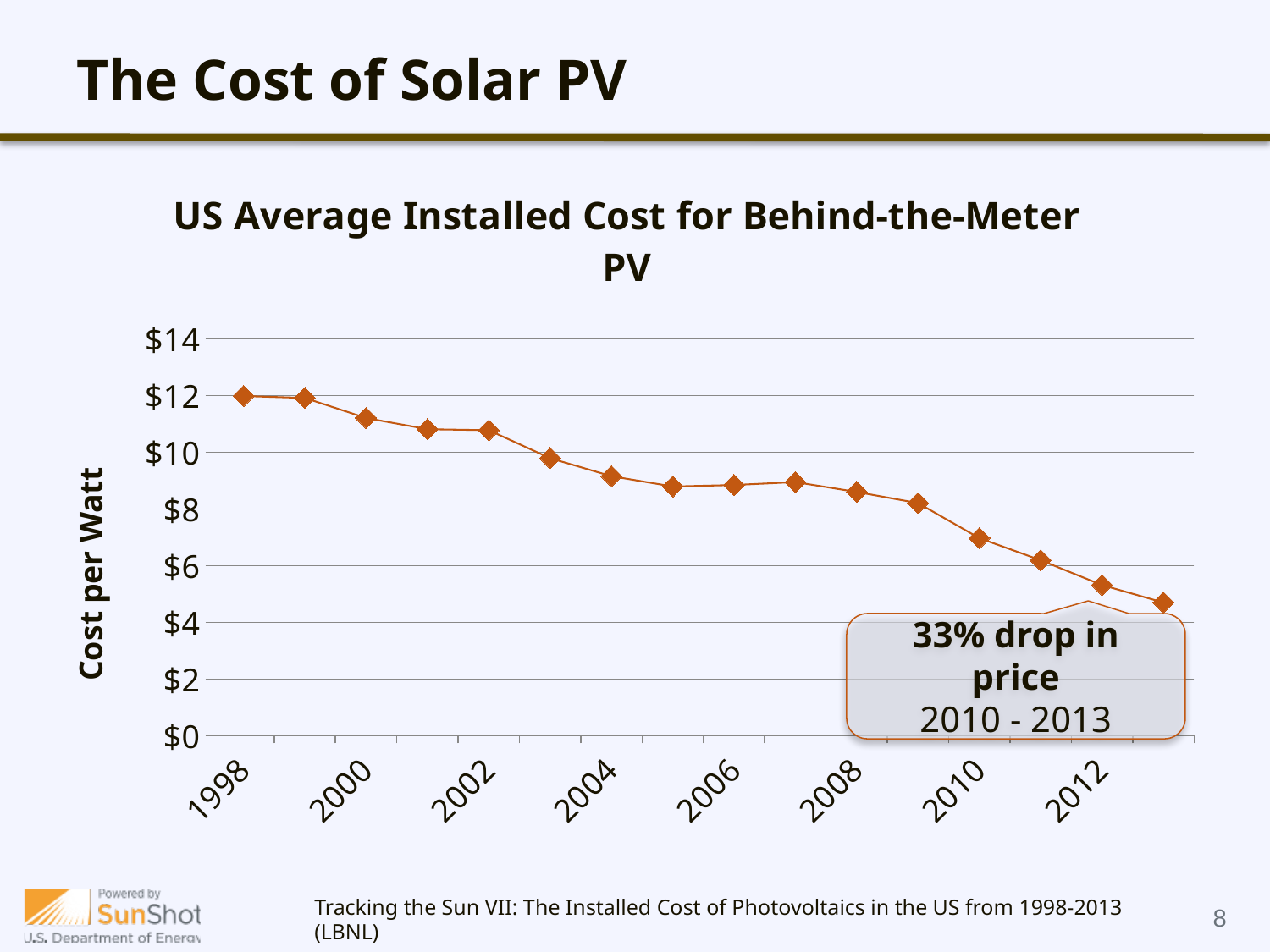
What is the label on the vertical axis of the chart? Cost per Watt Do the values rise or fall overall from 1998 to 2013? fall Is the value for 2013 greater or less than $4? greater What kind of chart is shown on the slide? line chart Which year has the highest cost per watt? 1998 How many data points are plotted on the line, covering the years 1998 through 2013? 16 Which year has the lowest cost per watt? 2013 Is the value for 2000 greater or less than $10? greater Is the value for 2004 greater or less than $10? less What is the title of the chart? US Average Installed Cost for Behind-the-Meter PV Which year has the larger cost per watt, 2003 or 2011? 2003